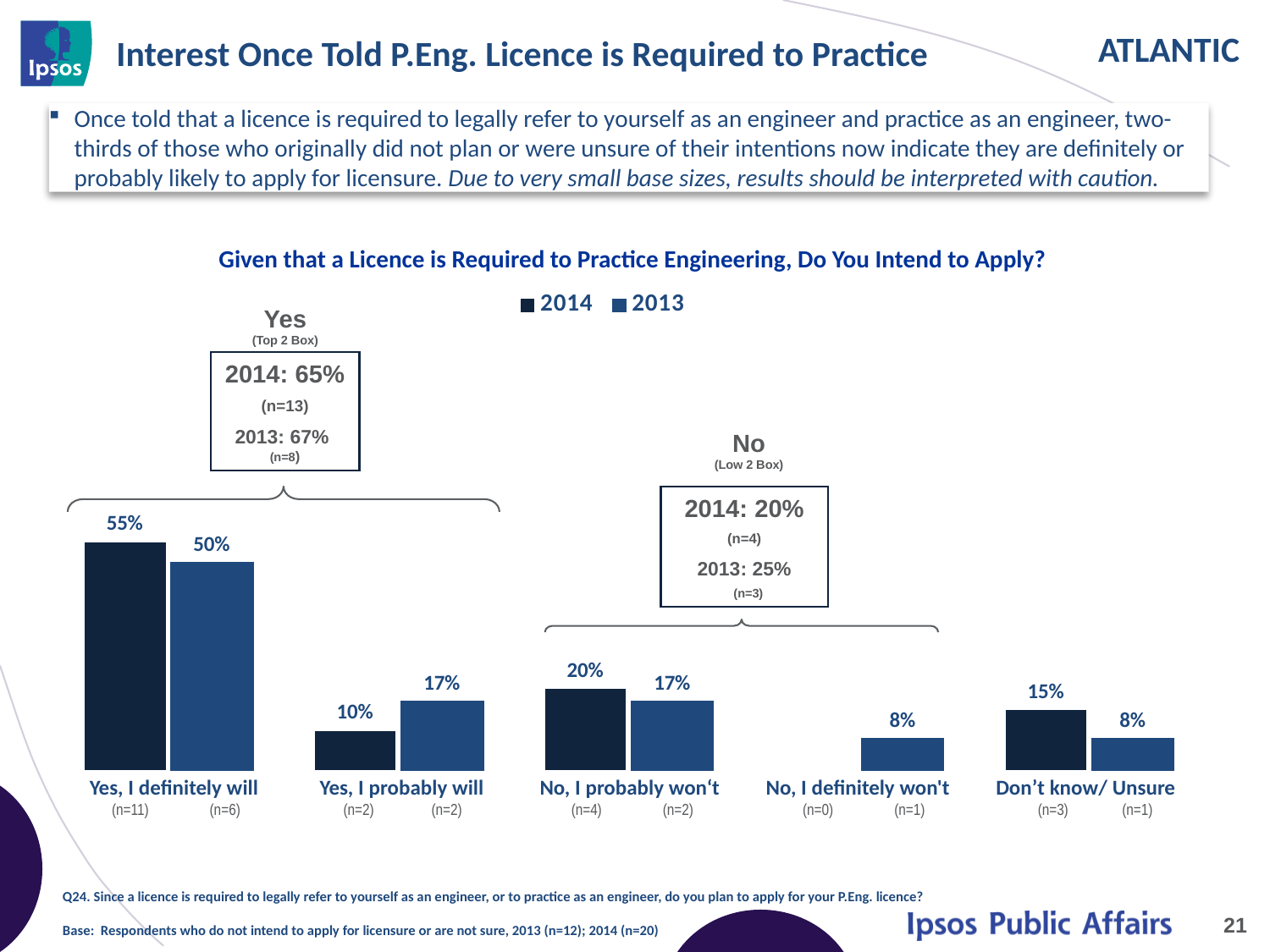
What is the 2014 value for "Yes, I definitely will"? 55% Which category has the highest 2014 value? Yes, I definitely will What is the difference between the 2014 and 2013 values for "Yes, I definitely will"? 5% What is the 2013 value for "Yes, I probably will"? 17% What is the 2013 value for "No, I definitely won't"? 8% Which category has the highest 2013 value? Yes, I definitely will What is the 2014 "Yes (Top 2 Box)" percentage shown in the callout box? 65% How many series does the legend list? 2 What type of chart is shown on the slide? Bar chart What is the 2014 value for "Don't know/ Unsure"? 15% Which is larger for "Yes, I probably will": the 2014 value or the 2013 value? 2013 How many response categories are shown on the x axis? 5